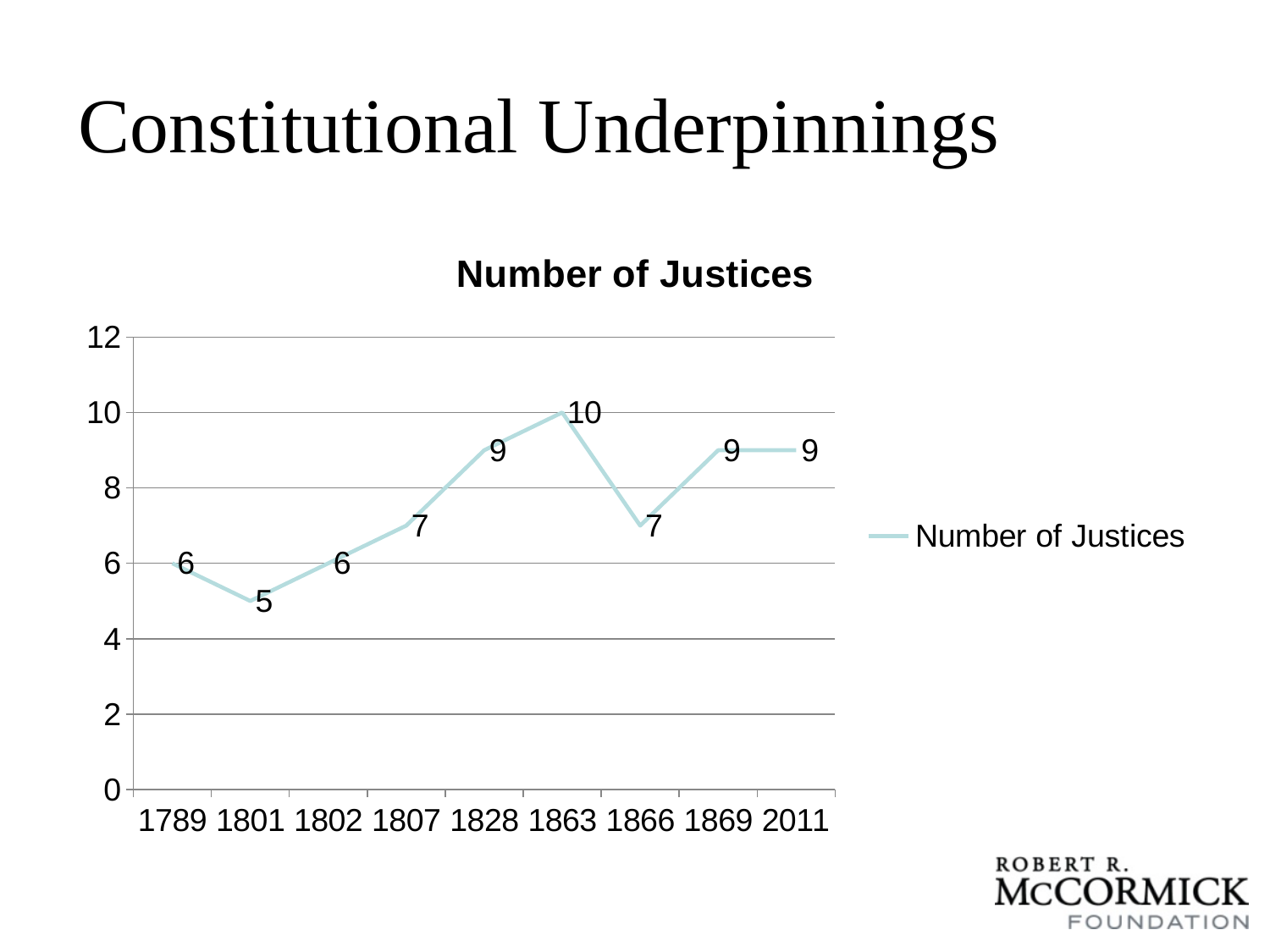
How many series does the legend list? 1 What is the number of justices in 1863? 10 What is the difference between the number of justices in 1863 and in 1866? 3 Is the number of justices in 1801 greater or less than 6? less What is the title of the chart? Number of Justices How many years are plotted on the x axis? 9 What kind of chart is shown? line chart What is the number of justices in 1866? 7 In which year is the number of justices highest? 1863 In which year is the number of justices lowest? 1801 Which year has more justices, 1807 or 1828? 1828 What is the number of justices in 1789? 6